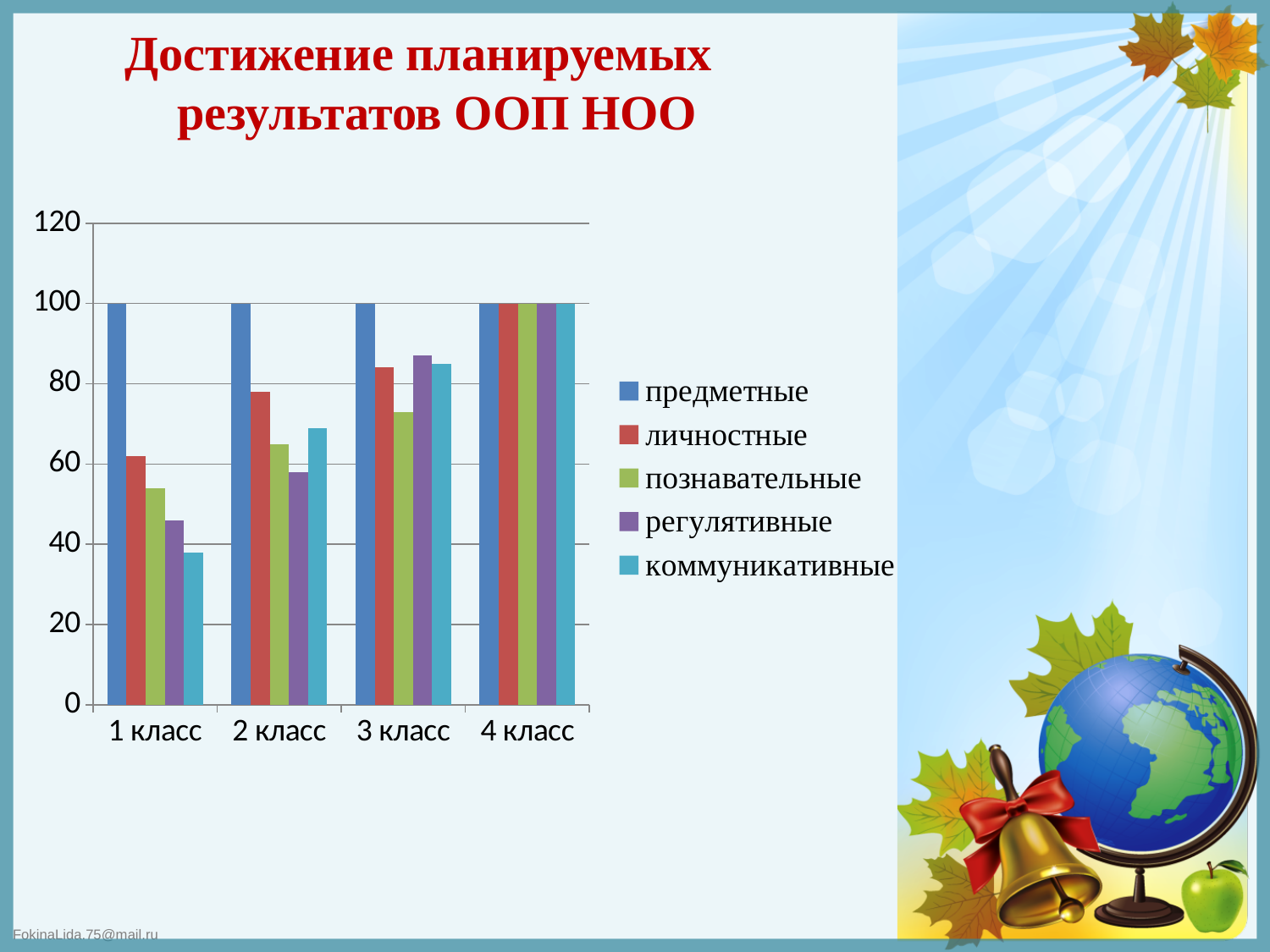
Do the values for коммуникативные rise or fall from 1 класс to 4 класс? rise In 2 класс, which is larger: коммуникативные or регулятивные? коммуникативные What is the value for предметные in 1 класс? 100 Is the value for познавательные in 1 класс greater or less than 60? less What colour represents предметные in the legend? blue How many series does the legend list? 5 What kind of chart is shown on the slide? bar chart How many categories (classes) are shown on the x axis? 4 Is the value for регулятивные in 1 класс greater or less than 40? greater Which series has the lowest value in 1 класс? коммуникативные What is the value for коммуникативные in 4 класс? 100 Is the value for познавательные in 3 класс greater or less than 80? less